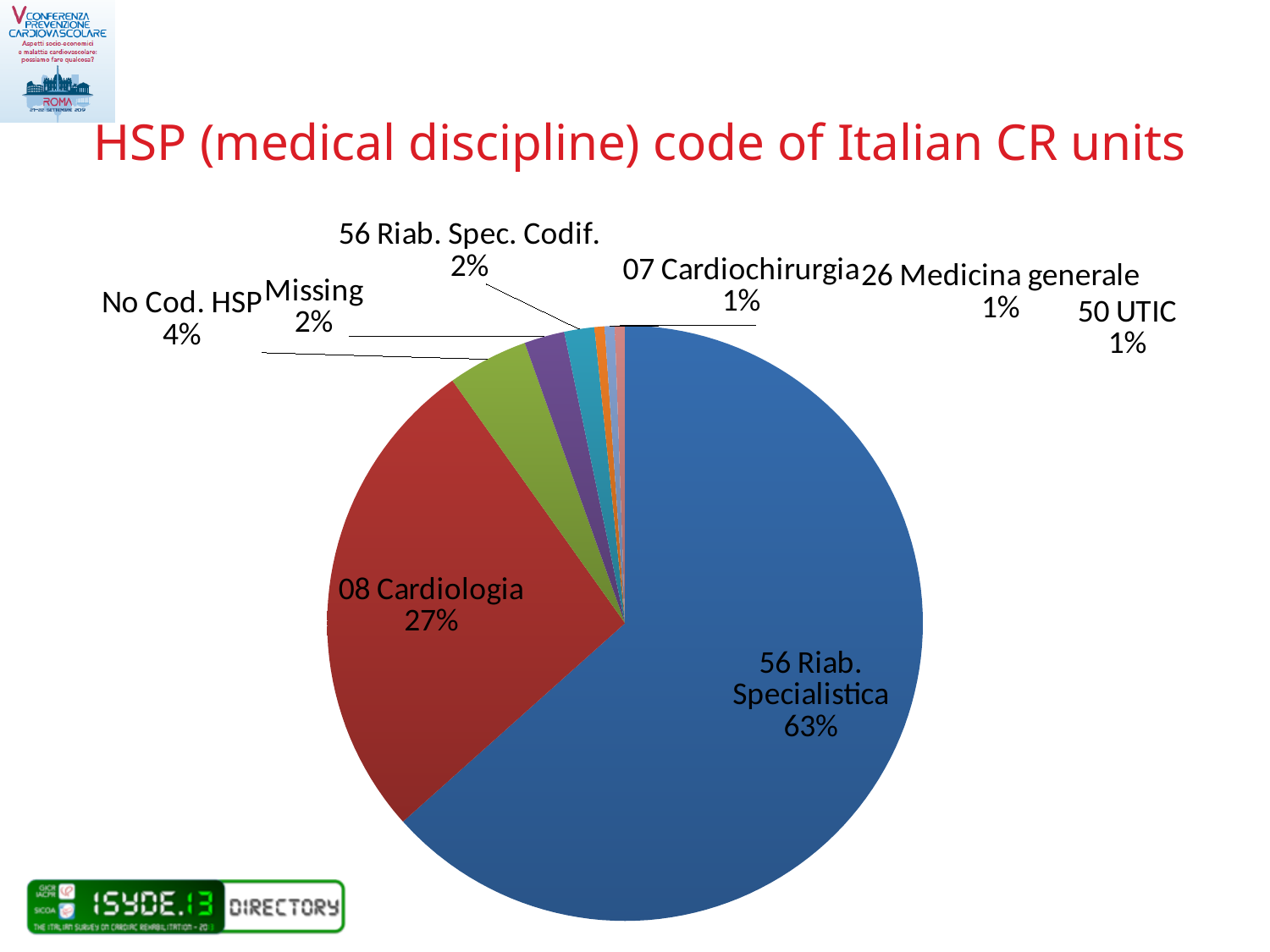
What is the value shown for 07 Cardiochirurgia? 1% Which category has the largest slice of the pie? 56 Riab. Specialistica What is the value shown for Missing? 2% What is the combined share of 56 Riab. Specialistica and 08 Cardiologia? 90% What type of chart is shown on the slide? Pie chart What is the title of the chart on the slide? HSP (medical discipline) code of Italian CR units What is the difference in percentage points between 56 Riab. Specialistica and 08 Cardiologia? 36 What share of the pie does 08 Cardiologia represent? 27% How many slices does the pie chart have? 8 What share of the pie does 56 Riab. Specialistica represent? 63% What is the value shown for No Cod. HSP? 4% Which is larger, the share for No Cod. HSP or the share for Missing? No Cod. HSP